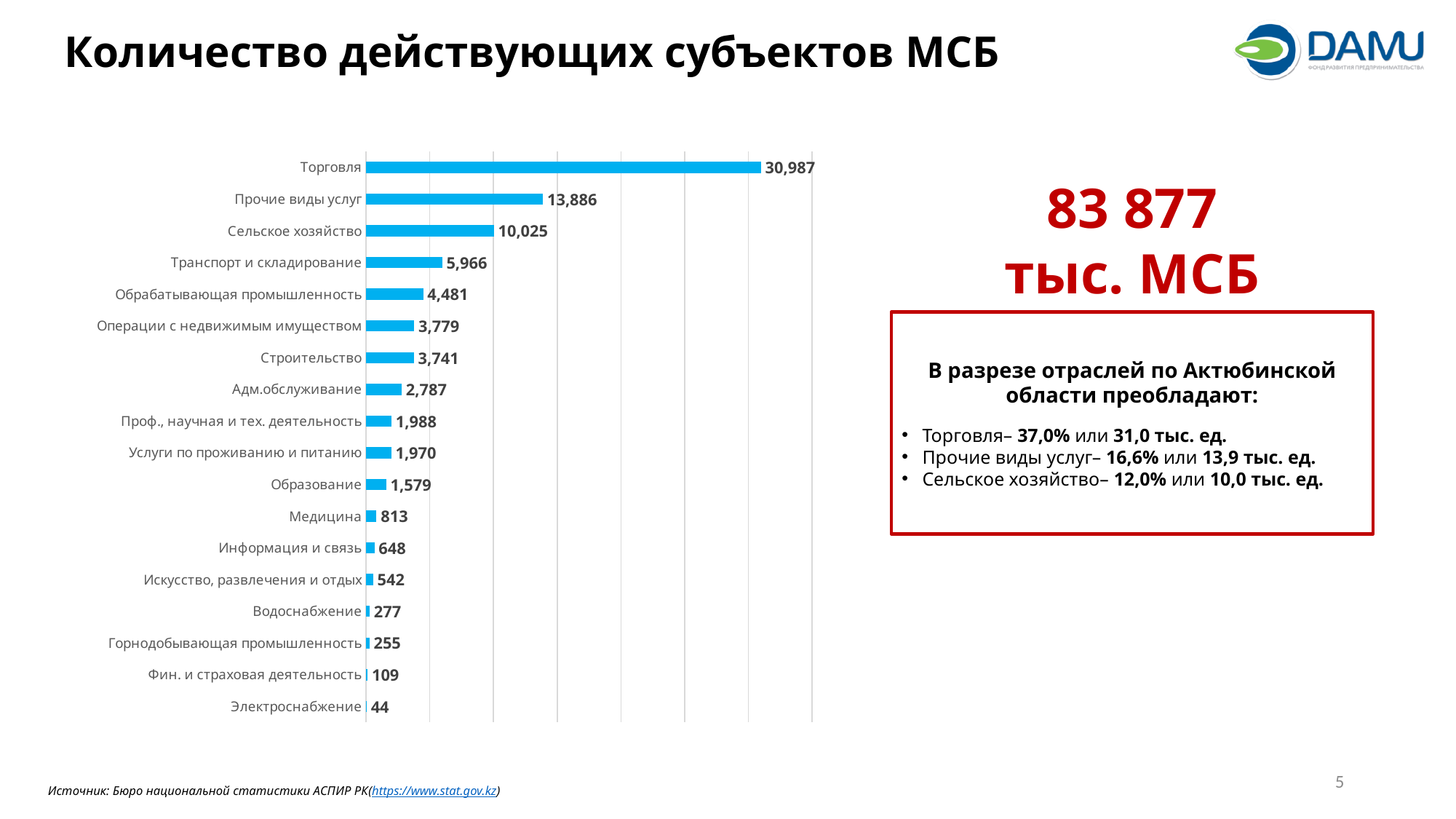
What is the value for Медицина? 813 What kind of chart is shown on the slide? Bar chart What is the difference between the values for Транспорт и складирование and Обрабатывающая промышленность? 1,485 What is the value for Торговля? 30,987 What is the value for Строительство? 3,741 What is the value for Сельское хозяйство? 10,025 Which category has the lowest value? Электроснабжение Which category has the highest value? Торговля What is the title of the slide containing the chart? Количество действующих субъектов МСБ What is the difference between the values for Торговля and Прочие виды услуг? 17,101 How many categories are shown in the chart? 18 Which is larger, the value for Образование or the value for Медицина? Образование